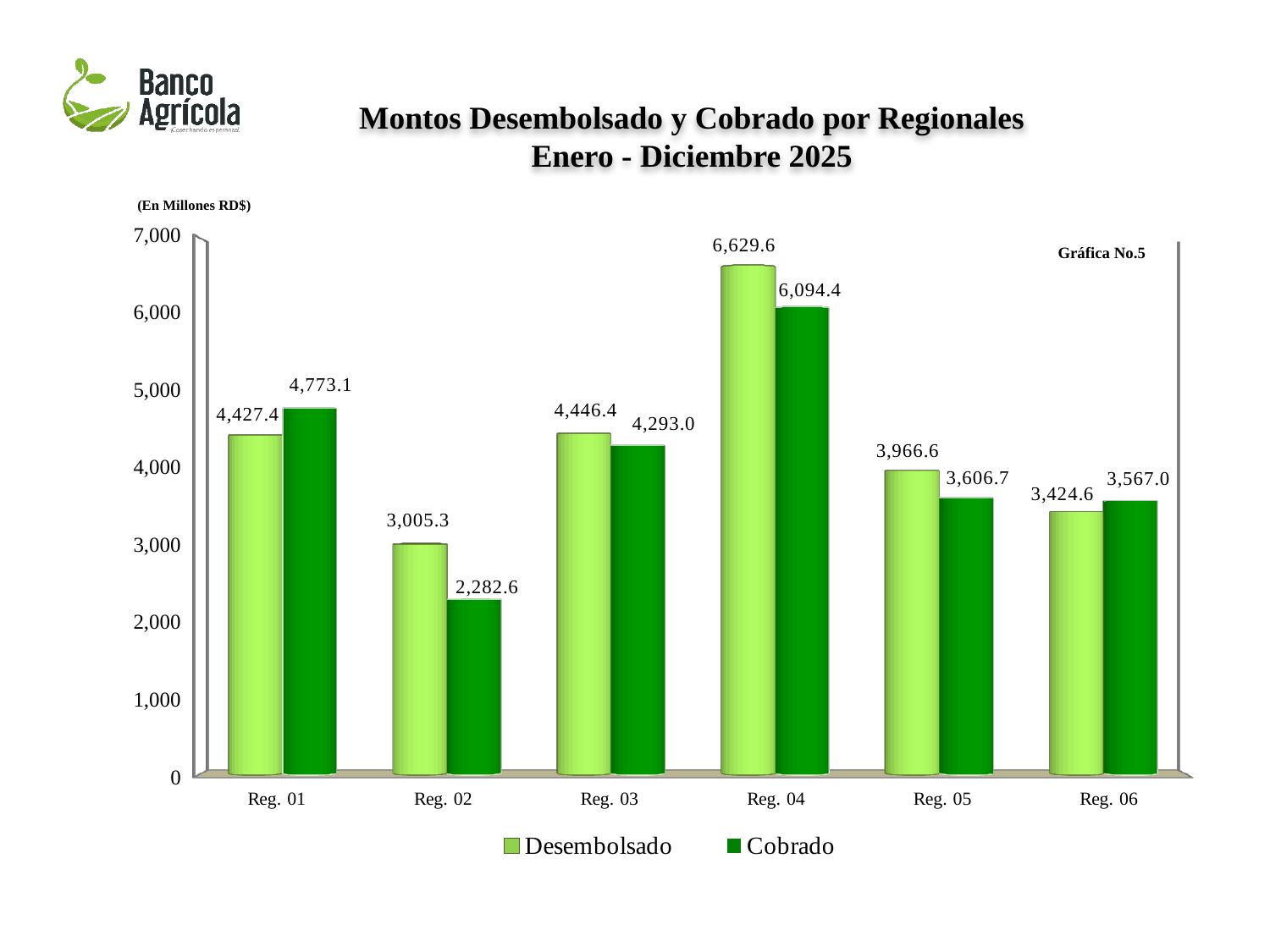
What is the difference between the Desembolsado and Cobrado values for Reg. 02? 722.7 How many series does the legend list? 2 How many regions are shown on the x axis? 6 What is the Cobrado value for Reg. 06? 3,567.0 What is the Cobrado value for Reg. 02? 2,282.6 What is the difference between the Desembolsado and Cobrado values for Reg. 04? 535.2 What kind of chart is shown on the slide? bar chart For Reg. 01, which is larger, Desembolsado or Cobrado? Cobrado Is the Cobrado value for Reg. 05 greater or less than 4,000? less Which region has the lowest Cobrado value? Reg. 02 Which region has the highest Desembolsado value? Reg. 04 What is the Desembolsado value for Reg. 04? 6,629.6